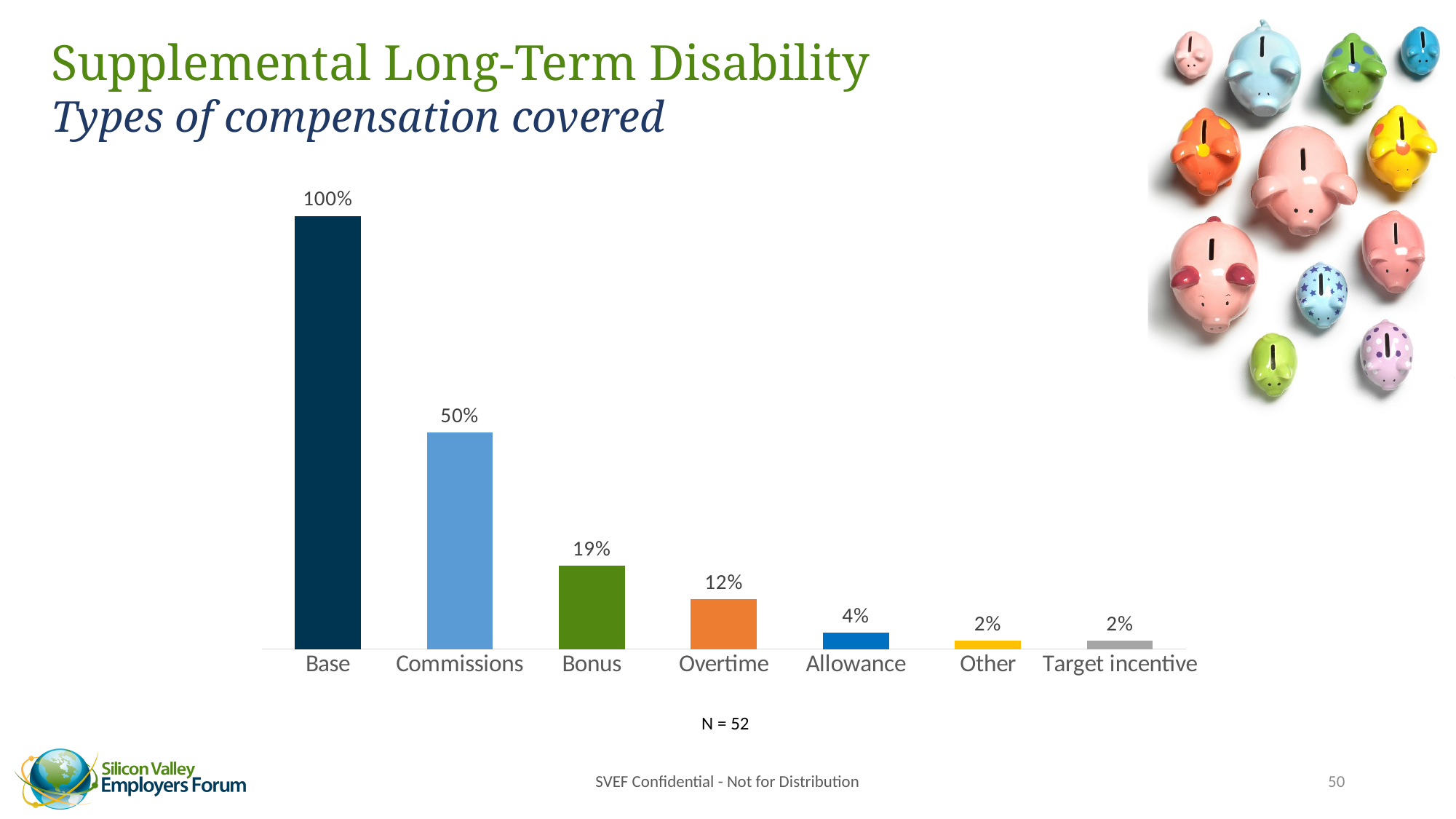
What percentage is shown for Base? 100% Do the values rise or fall moving from left to right across the categories? Fall What is the difference between the values for Base and Overtime? 88% How many compensation types are shown on the chart? 7 What is the difference between the values for Commissions and Bonus? 31% What percentage is shown for Overtime? 12% Which is larger, the value for Bonus or the value for Overtime? Bonus What kind of chart is shown on the slide? Bar chart Which type of compensation has the highest value? Base What percentage is shown for Commissions? 50% What percentage is shown for Allowance? 4% What sample size (N) is noted below the chart? N = 52